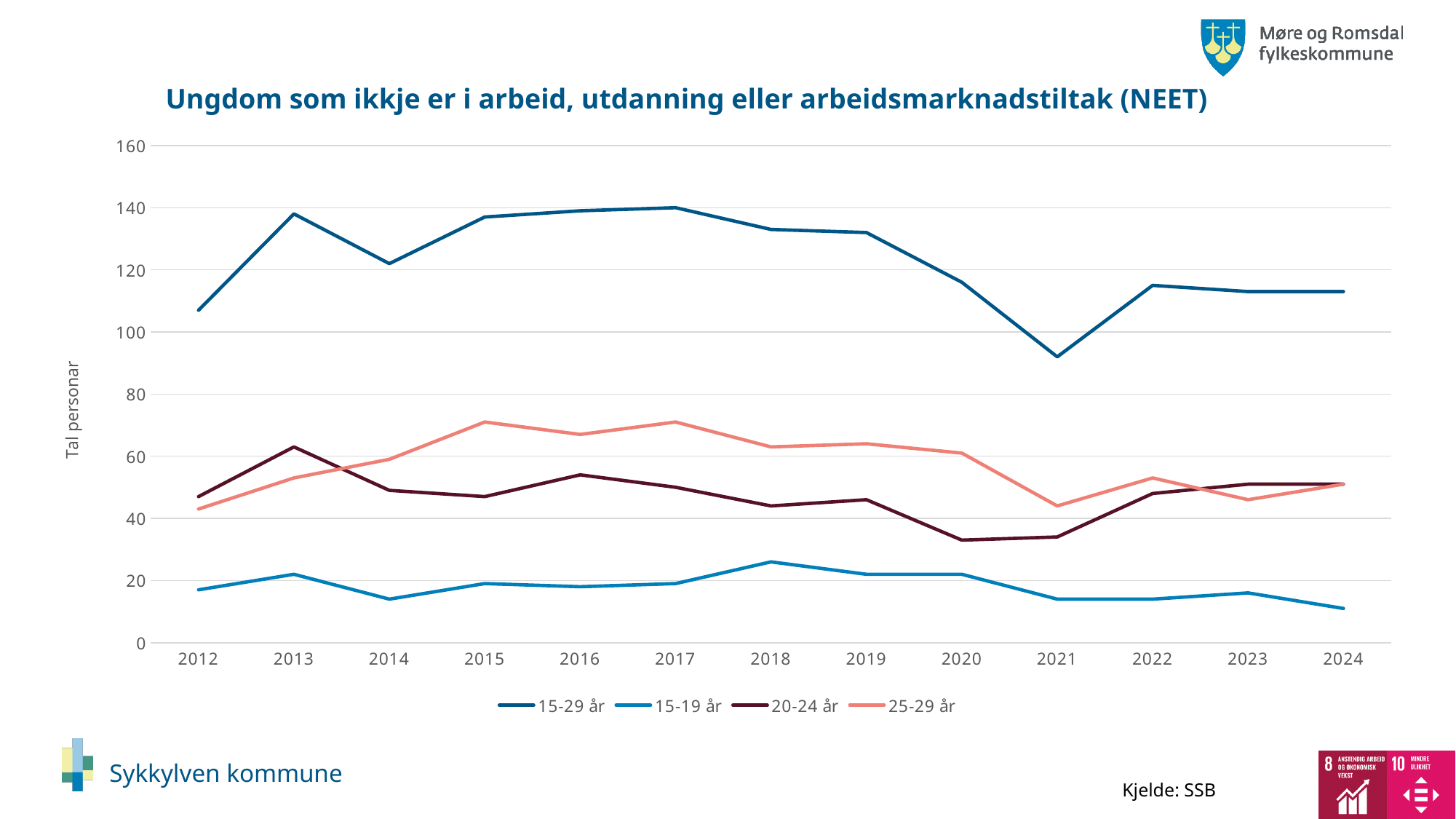
Does the value for 15-29 år rise or fall from 2017 to 2021? fall Is the value for 15-19 år in 2024 greater or less than 20? less Is the value for 25-29 år in 2015 greater or less than 60? greater What is the label on the y axis? Tal personar What kind of chart is shown on the slide? line chart In which year is the value for 15-19 år highest? 2018 Is the value for 15-29 år in 2021 greater or less than 100? less In which year is the value for 20-24 år highest? 2013 In which year is the value for 15-29 år lowest? 2021 How many series does the legend list? 4 In 2020, which series has the larger value: 20-24 år or 25-29 år? 25-29 år How many years are plotted along the x axis? 13